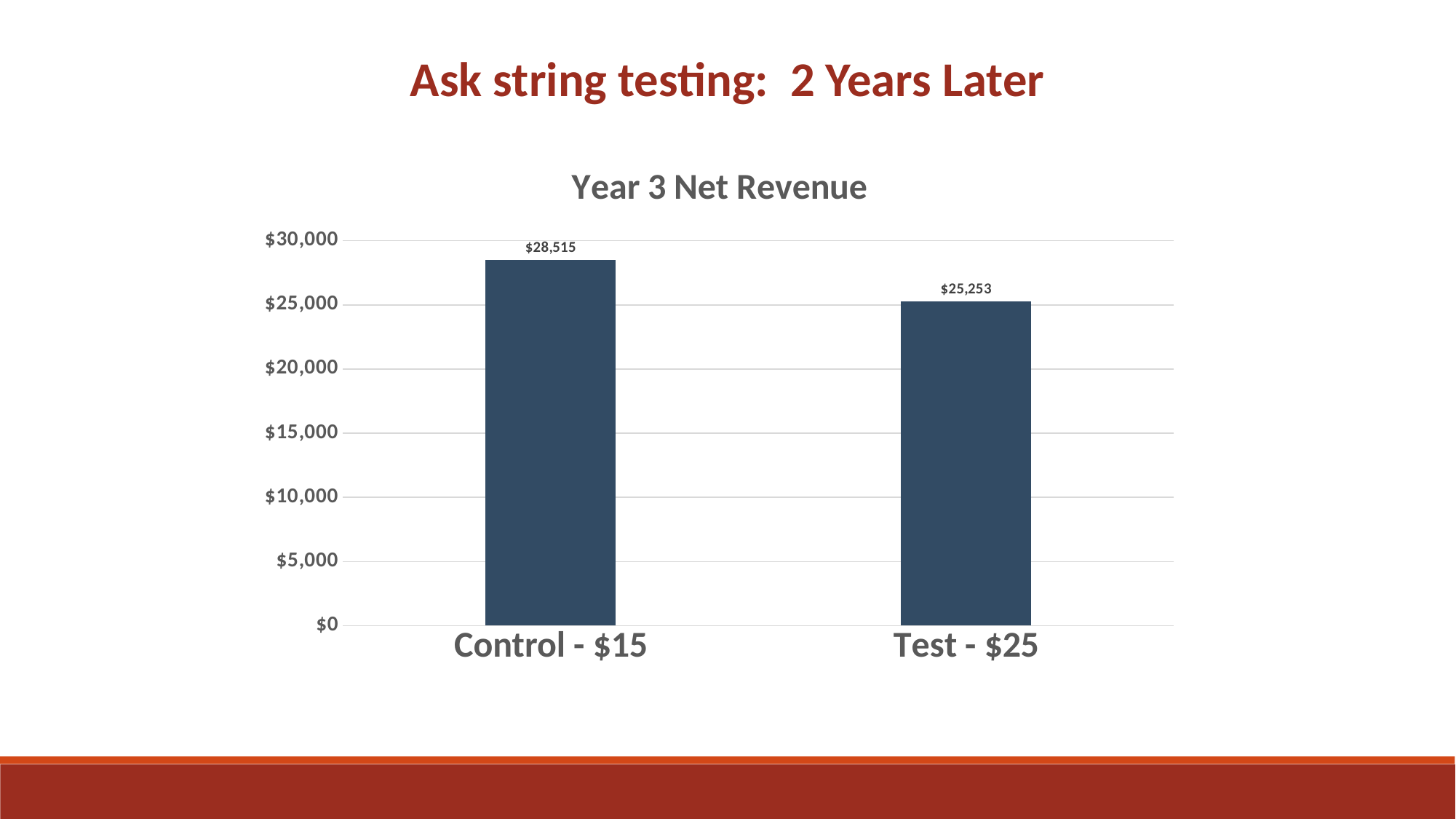
What is the difference in Year 3 Net Revenue between Control - $15 and Test - $25? $3,262 What is the Year 3 Net Revenue for Test - $25? $25,253 Which category has the lowest Year 3 Net Revenue? Test - $25 What kind of chart is shown on the slide? bar chart Which category has the highest Year 3 Net Revenue? Control - $15 What is the highest value shown on the vertical axis? $30,000 What is the Year 3 Net Revenue for Control - $15? $28,515 Is the value for Control - $15 greater or less than $30,000? less Which has a larger Year 3 Net Revenue, Control - $15 or Test - $25? Control - $15 How many categories are shown in the chart? 2 Is the value for Test - $25 greater or less than $25,000? greater What is the title of the chart? Year 3 Net Revenue